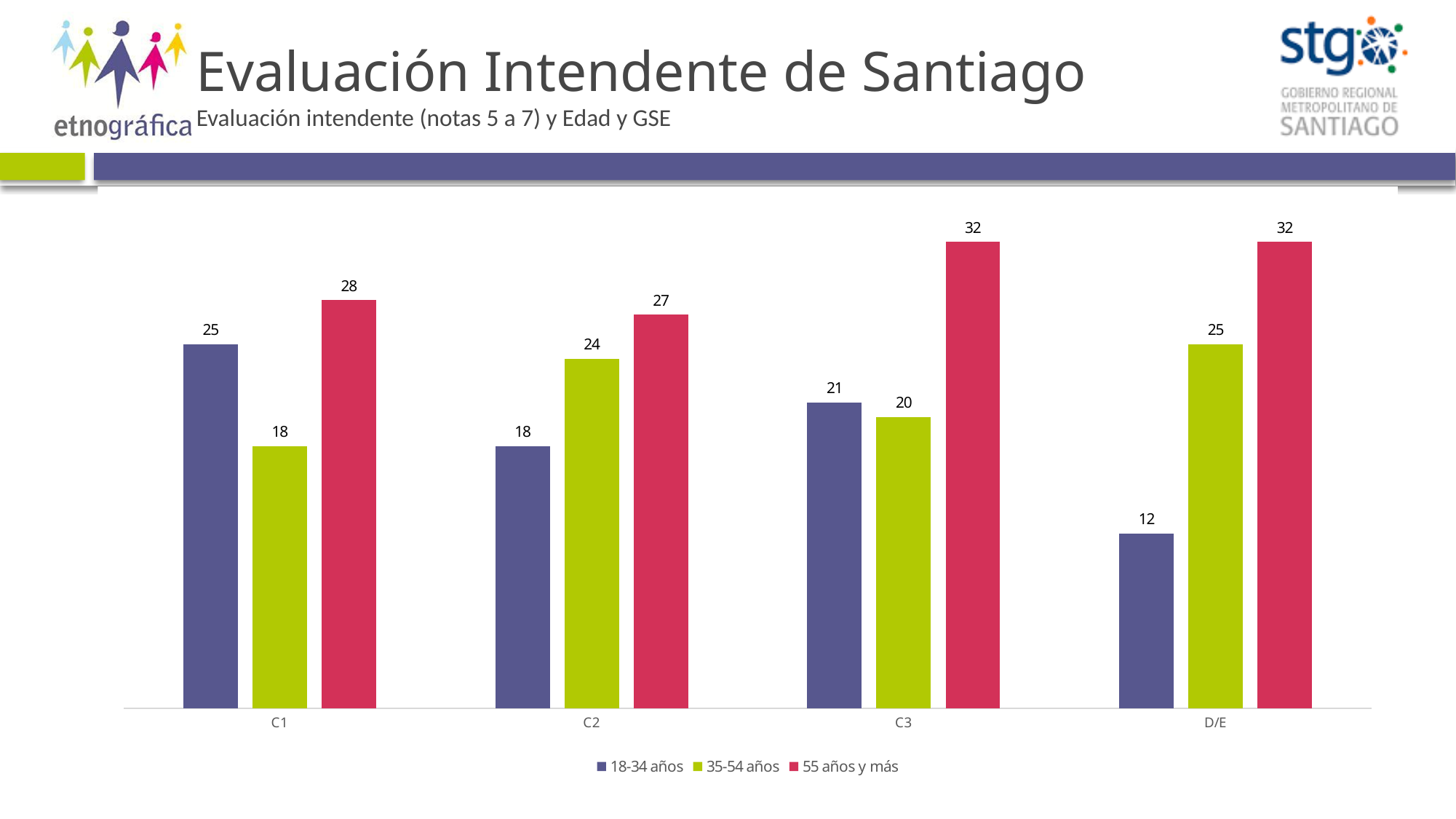
In the C3 category, which is larger: the value for 18-34 años or for 35-54 años? 18-34 años What is the value for 35-54 años in the D/E category? 25 What is the value for 55 años y más in the C2 category? 27 How many series does the legend list? 3 What kind of chart is shown on the slide? Bar chart Which category has the lowest value for 18-34 años? D/E What is the subtitle of the chart on the slide? Evaluación intendente (notas 5 a 7) y Edad y GSE How many categories are shown on the x axis? 4 Do the values for 55 años y más rise or fall from C1 to C3? Rise What is the difference between the 55 años y más and 18-34 años values in the D/E category? 20 What is the value for 18-34 años in the C1 category? 25 Which category has the highest value for 35-54 años? D/E